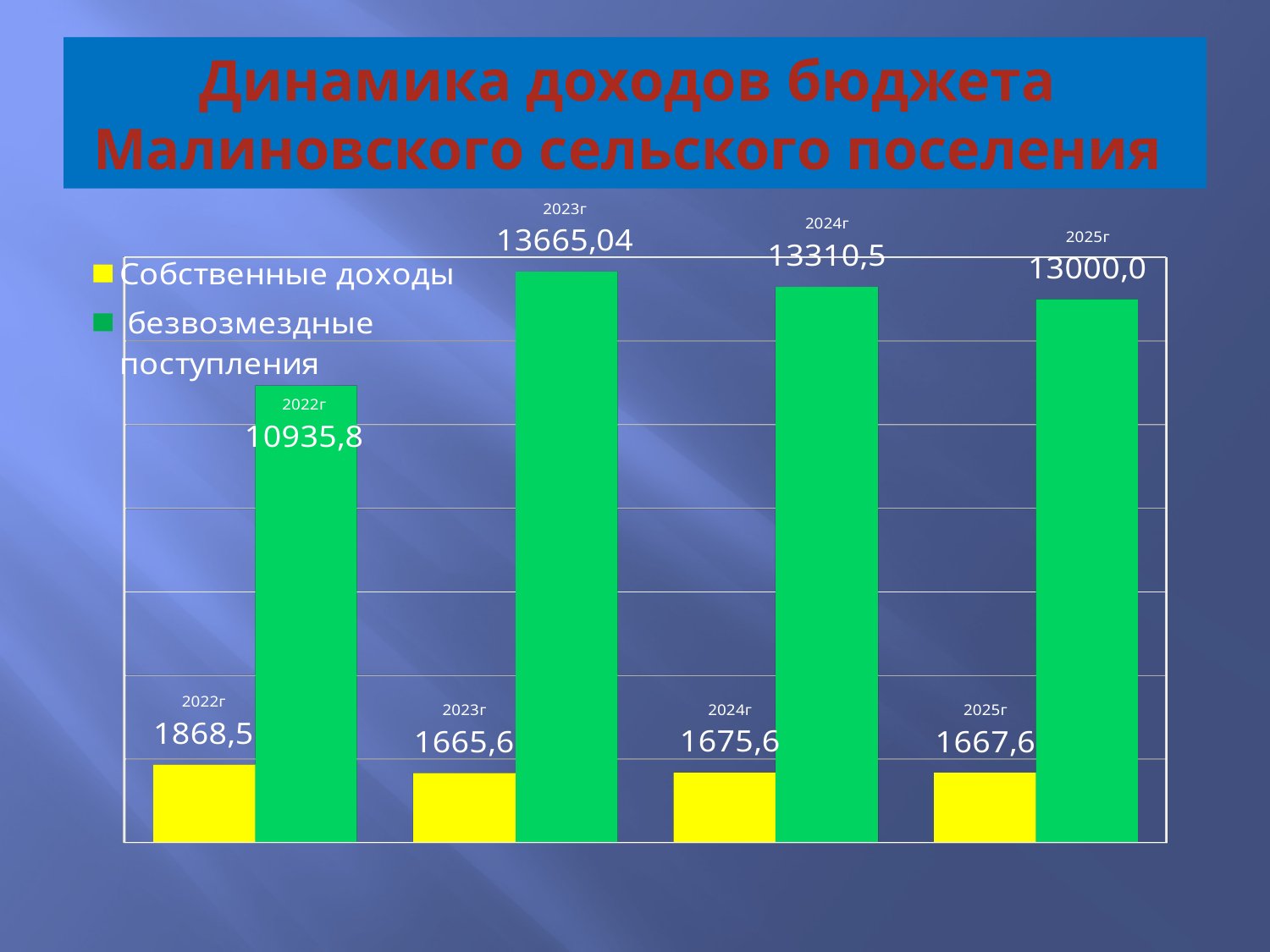
Which is larger: Собственные доходы in 2024г or in 2025г? 2024г What is the value of безвозмездные поступления for 2025г? 13000,0 What is the difference between безвозмездные поступления in 2023г and 2024г? 354,54 How many years (categories) are shown on the chart? 4 What is the total of Собственные доходы and безвозмездные поступления for 2022г? 12804,3 In which year is Собственные доходы the lowest? 2023г What is the value of безвозмездные поступления for 2023г? 13665,04 What type of chart is shown on the slide? bar chart What is the value of Собственные доходы for 2022г? 1868,5 Which colour represents Собственные доходы in the chart? yellow How many series does the legend list? 2 In which year is безвозмездные поступления the highest? 2023г